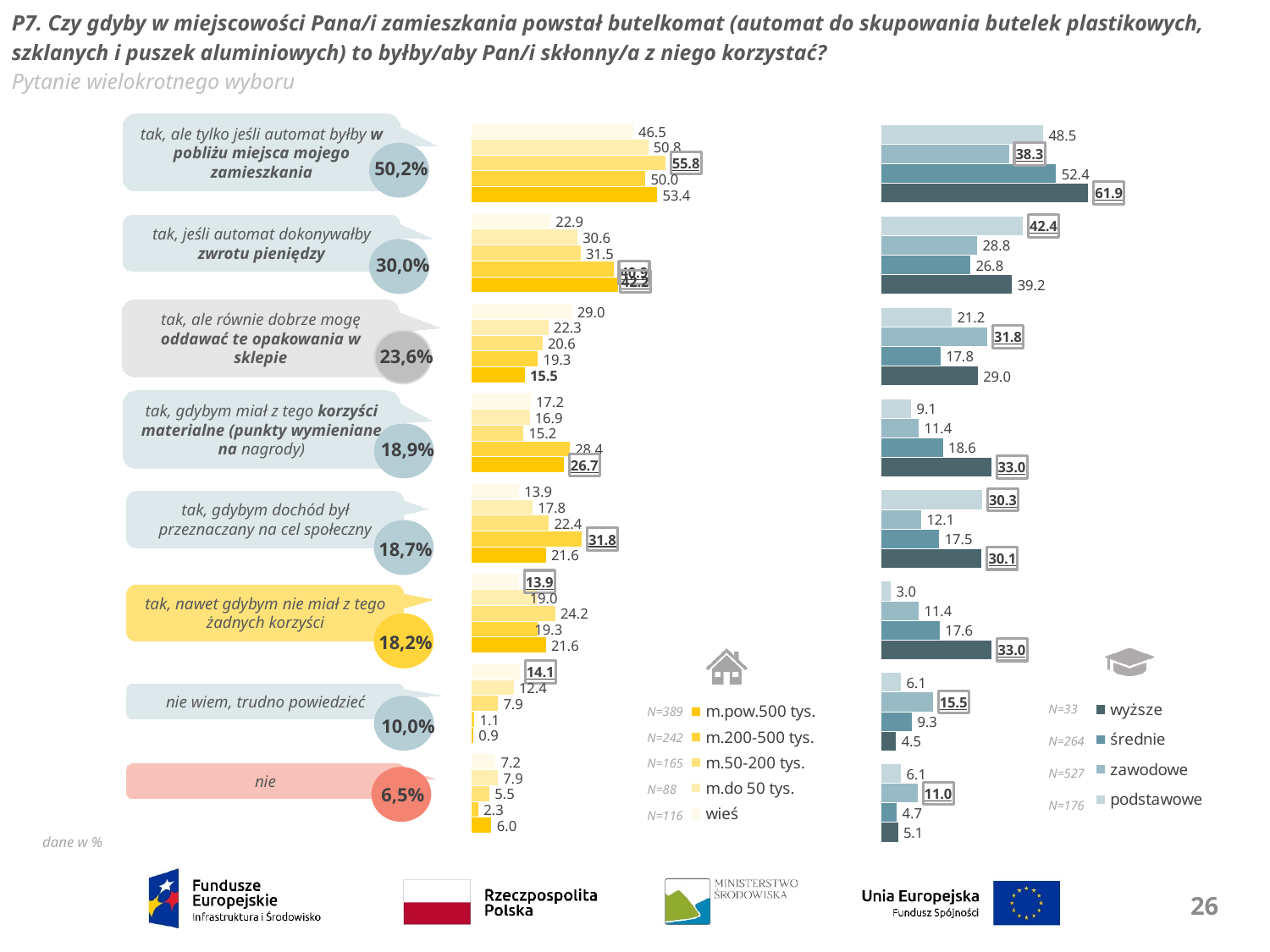
In the left (yellow) chart, what is the value for 'm.pow.500 tys.' for 'tak, ale równie dobrze mogę oddawać te opakowania w sklepie'? 15.5 In the right (blue) chart, what is the value for 'wyższe' for 'tak, ale tylko jeśli automat byłby w pobliżu miejsca mojego zamieszkania'? 61.9 Which response has the highest overall percentage? tak, ale tylko jeśli automat byłby w pobliżu miejsca mojego zamieszkania In the right (blue) chart, what sample size (N) is given for 'wyższe'? N=33 In the left (yellow) chart, how many series does the legend list? 5 In the left (yellow) chart, for 'nie wiem, trudno powiedzieć', which is larger: the value for 'wieś' or for 'm.pow.500 tys.'? wieś In the right (blue) chart, what is the difference between 'wyższe' (61.9) and 'podstawowe' (48.5) for 'tak, ale tylko jeśli automat byłby w pobliżu miejsca mojego zamieszkania'? 13.4 What is the overall percentage shown for 'tak, ale tylko jeśli automat byłby w pobliżu miejsca mojego zamieszkania'? 50,2% In the right (blue) chart, how many series does the legend list? 4 What is the overall percentage shown for the response 'nie'? 6,5% How many response categories are shown on the slide? 8 What kind of chart is used on this slide to show the results by town size and by education? bar chart